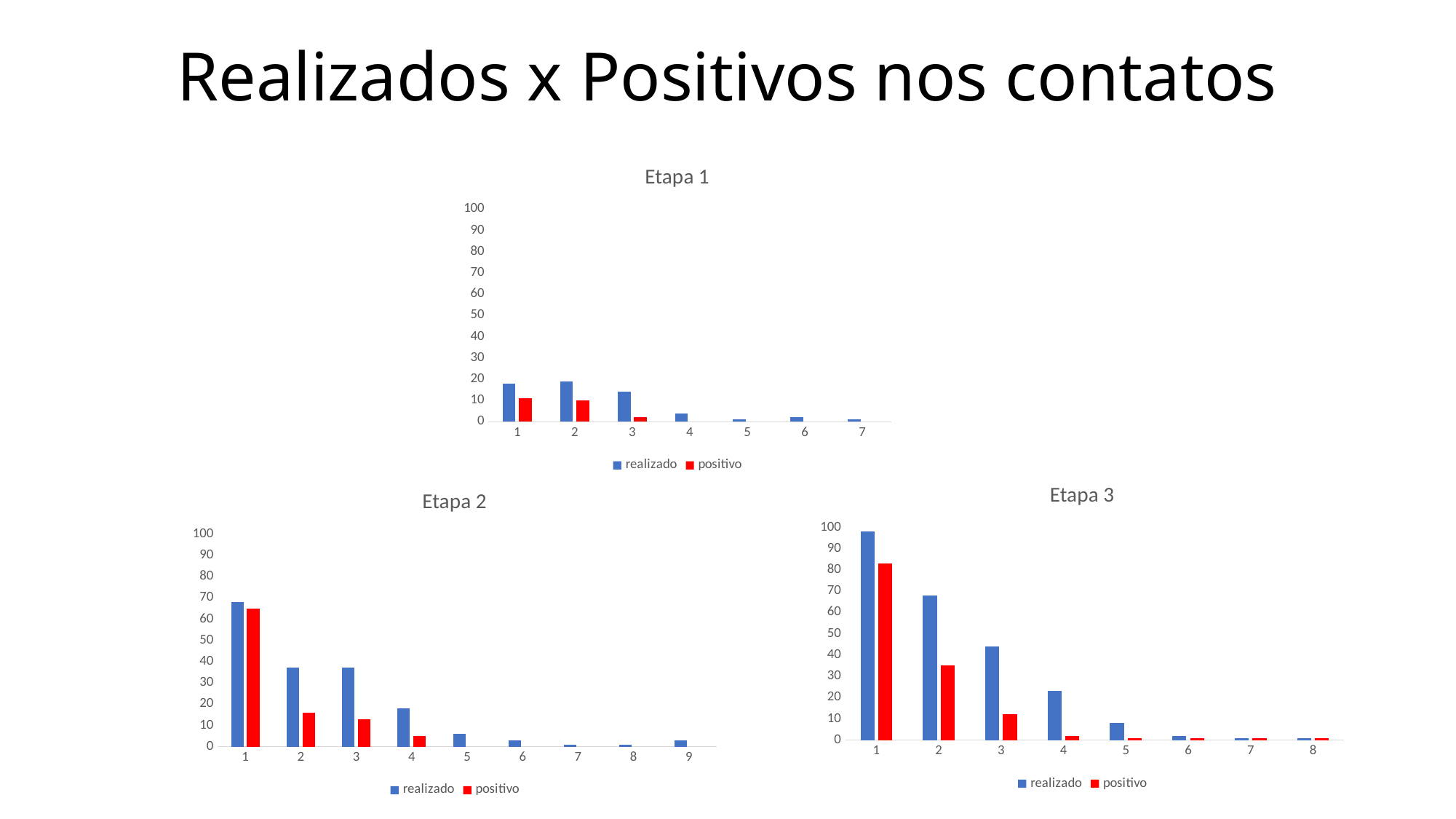
In the Etapa 3 chart, is the realizado value for category 1 greater or less than 90? greater In the Etapa 1 chart, is the realizado value for category 1 greater or less than 20? less In the Etapa 3 chart, do the realizado values rise or fall from category 1 to category 8? fall In the Etapa 3 chart, which category has the highest realizado value? 1 How many series does the legend of the Etapa 2 chart list? 2 In the Etapa 2 chart, is the positivo value for category 2 greater or less than 20? less In the Etapa 2 chart, which category has the highest positivo value? 1 How many categories are shown on the x axis of the Etapa 3 chart? 8 What type of chart is the Etapa 1 chart? bar chart In the Etapa 3 chart, for category 2, which is larger: realizado or positivo? realizado How many categories are shown on the x axis of the Etapa 2 chart? 9 How many categories are shown on the x axis of the Etapa 1 chart? 7